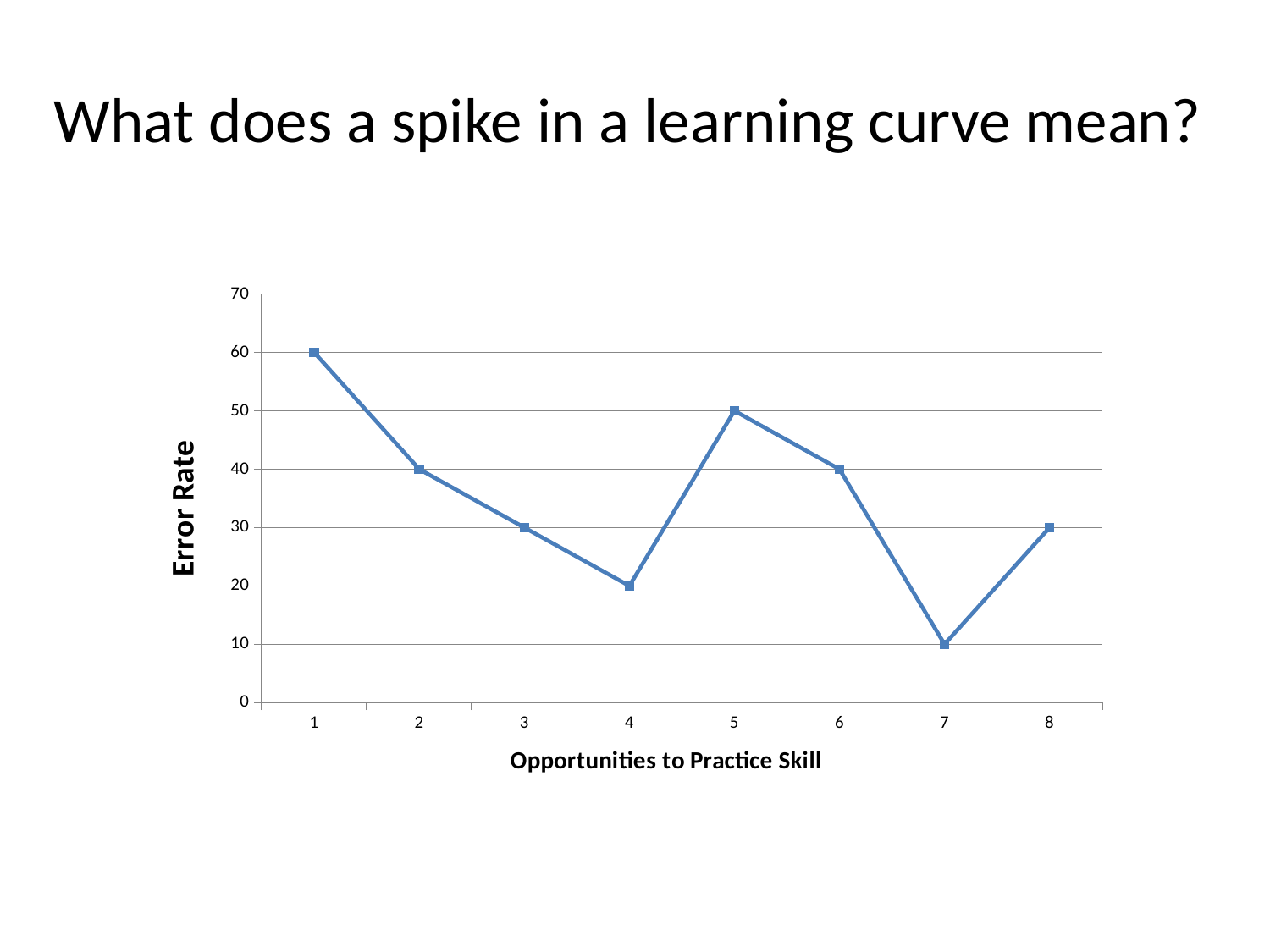
What is the difference in error rate between opportunity 4 and opportunity 5? 30 What kind of chart is shown on the slide? line chart At which opportunity to practice skill is the error rate lowest? 7 Does the error rate rise or fall from opportunity 1 to opportunity 4? fall What is the label of the x axis? Opportunities to Practice Skill Which has a higher error rate, opportunity 3 or opportunity 6? opportunity 6 What is the error rate at opportunity 5? 50 What is the error rate at opportunity 7? 10 What is the error rate at opportunity 1? 60 At which opportunity to practice skill is the error rate highest? 1 How many opportunities to practice skill are plotted on the x axis? 8 What is the label of the y axis? Error Rate